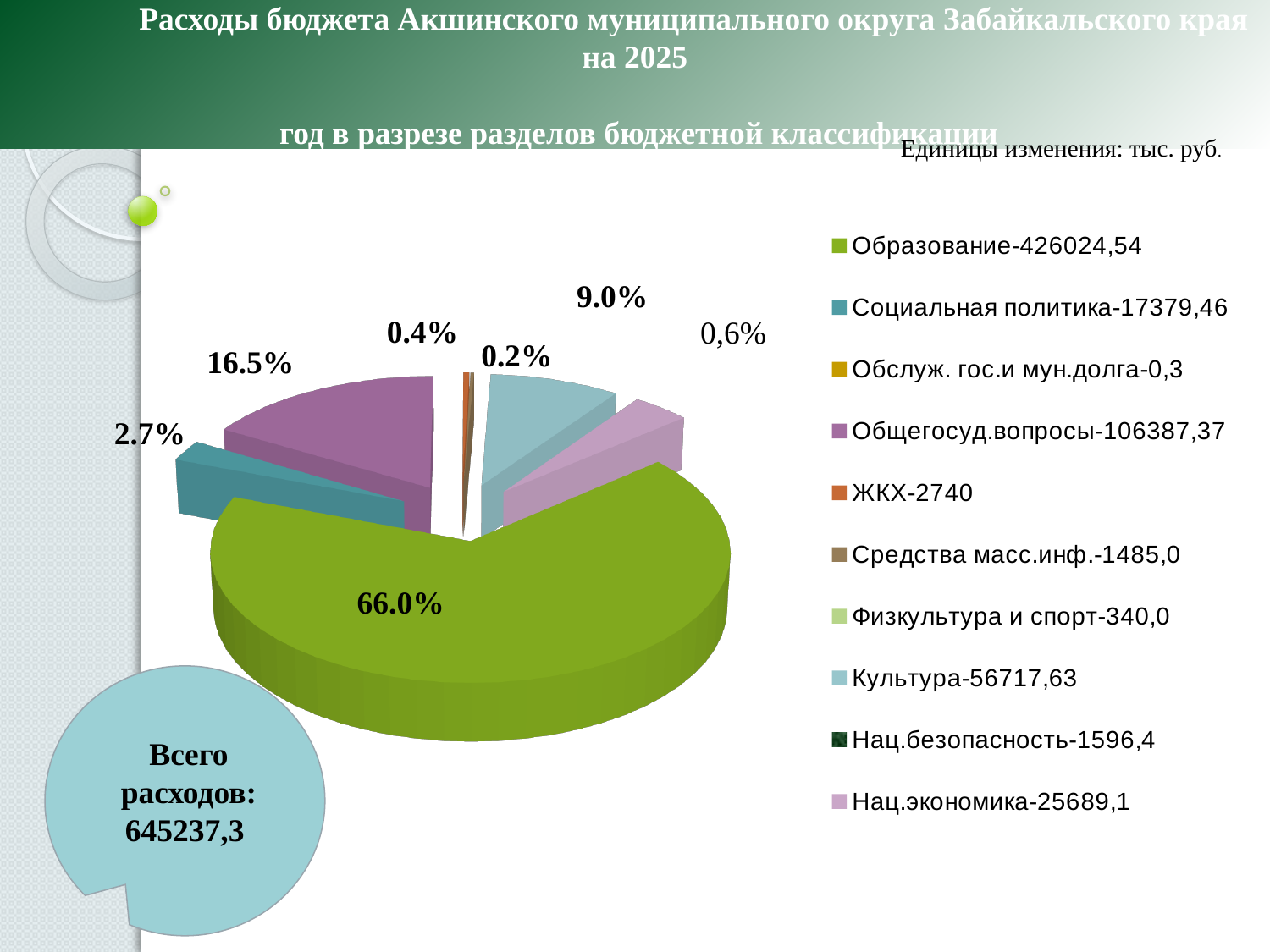
What is the value shown in the legend for Культура? 56717,63 Which is larger, the value for Общегосуд.вопросы or the value for Социальная политика? Общегосуд.вопросы How many entries does the legend of the pie chart list? 10 What is the difference between the legend values for Образование and Общегосуд.вопросы? 319637,17 Which legend entry has the smallest value? Обслуж. гос.и мун.долга Which category has the largest slice of the pie? Образование What share of the pie does Образование take? 66.0% What is the value shown in the legend for Образование? 426024,54 What kind of chart is shown on the slide? pie chart What total expenditure (Всего расходов) is stated on the slide? 645237,3 What is the value shown in the legend for ЖКХ? 2740 What share of the pie does Общегосуд.вопросы take? 16.5%